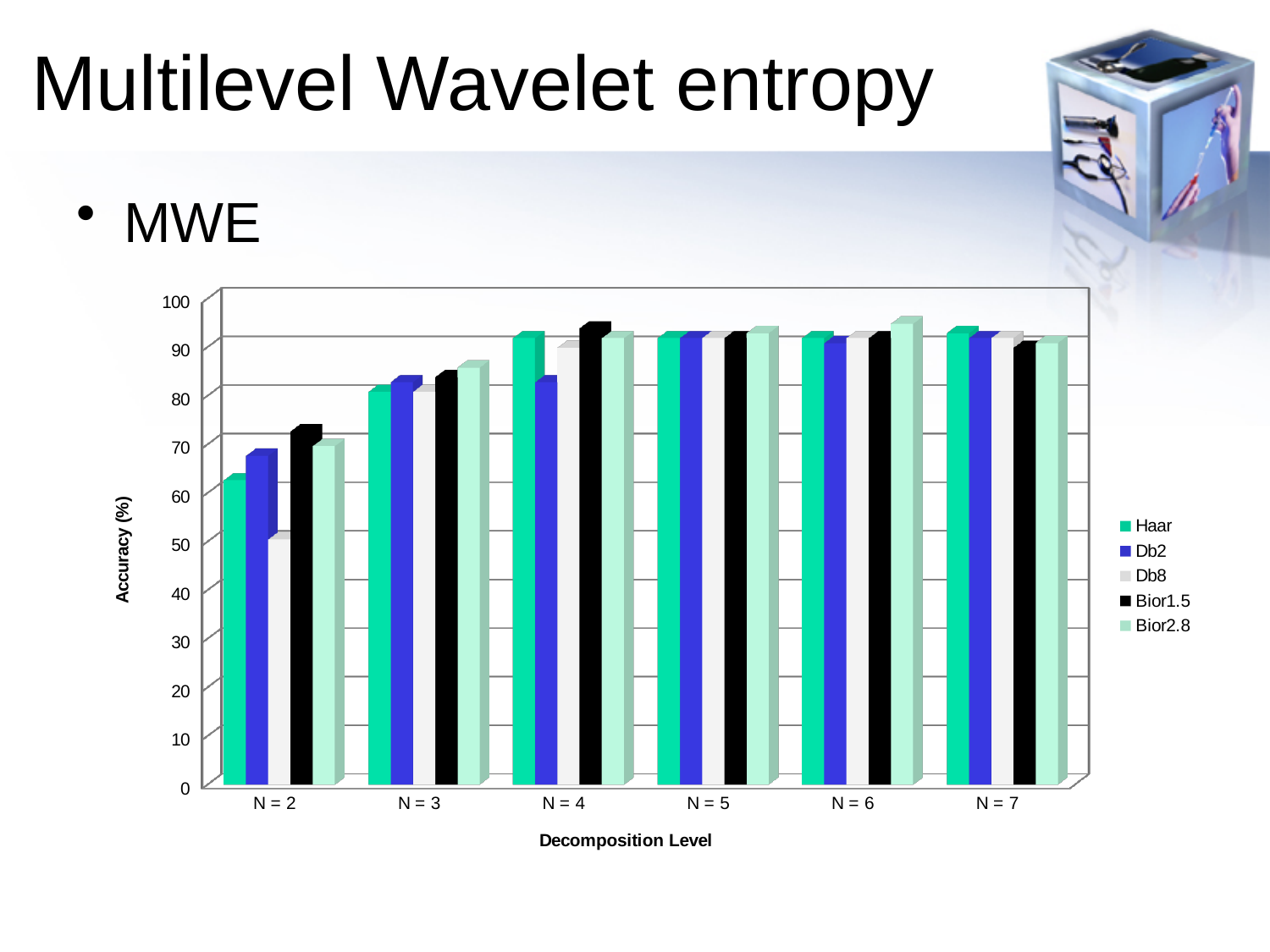
Is the value for Db8 at N = 2 greater or less than 60? less What is the label of the horizontal axis? Decomposition Level Does the accuracy for Haar generally rise or fall as the decomposition level increases from N = 2 to N = 7? rise What kind of chart is shown on the slide? bar chart How many series does the legend list? 5 How many decomposition levels (categories) are shown on the x axis? 6 What is the label of the vertical axis? Accuracy (%) At N = 2, which is larger: Haar or Db8? Haar Is the value for Db2 at N = 4 greater or less than 90? less Which series has the lowest accuracy at N = 2? Db8 Is the value for Bior1.5 at N = 4 greater or less than 80? greater